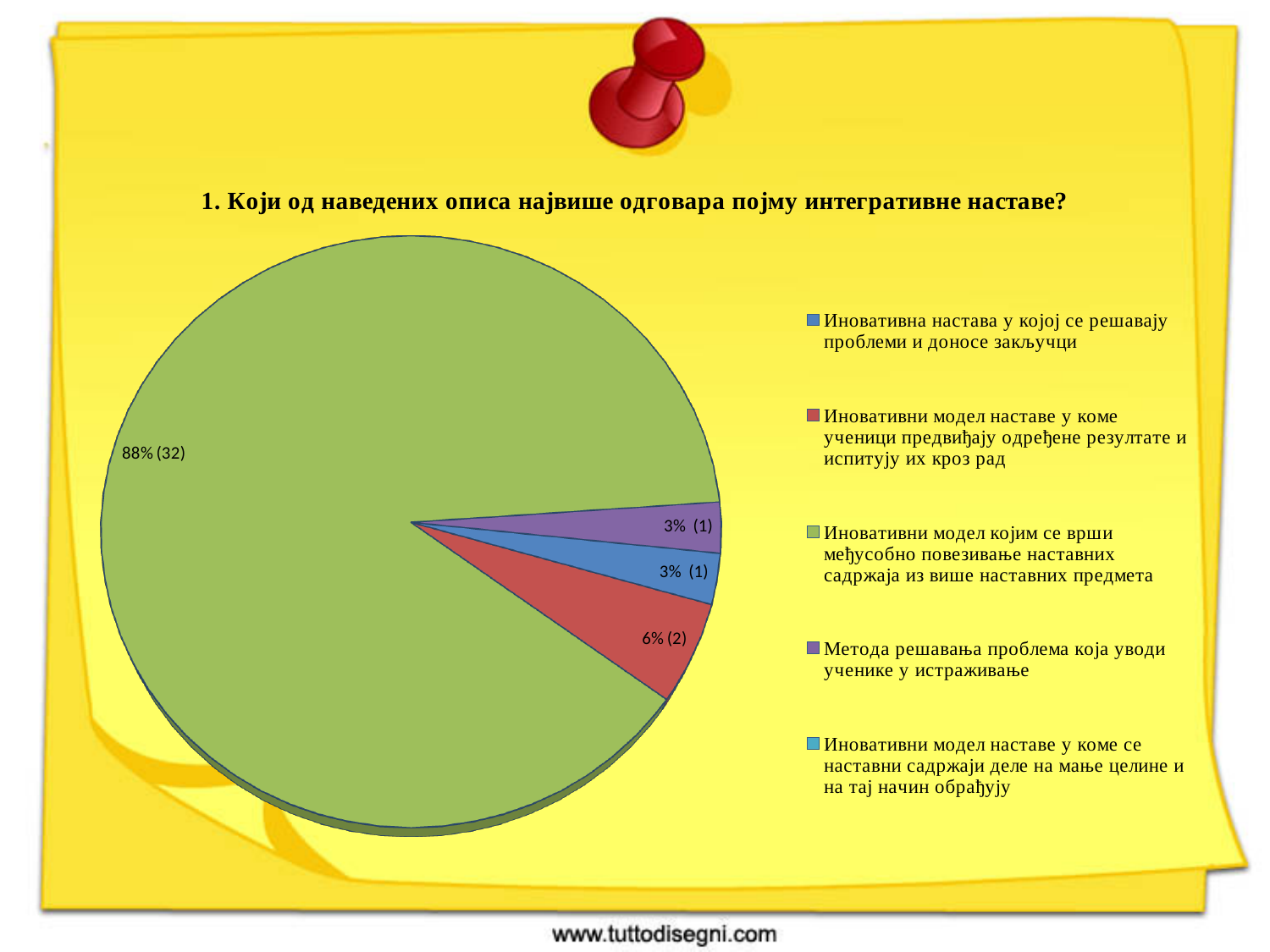
Which slice is larger, the red one (6%) or the blue one (3%)? The red one Is the share of the green slice greater or less than 50%? greater What kind of chart is shown on the slide? Pie chart What is the title of the chart? 1. Који од наведених описа највише одговара појму интегративне наставе? How many more respondents chose the green category (32) than the red category (2)? 30 What is the data label shown on the green slice (Иновативни модел којим се врши међусобно повезивање наставних садржаја из више наставних предмета)? 88% (32) What percentage share does the purple slice (Метода решавања проблема која уводи ученике у истраживање) have? 3% Which legend category has the largest slice of the pie? Иновативни модел којим се врши међусобно повезивање наставних садржаја из више наставних предмета How many respondents are shown in parentheses for the blue slice (Иновативна настава у којој се решавају проблеми и доносе закључци)? 1 How many entries does the legend of the pie chart list? 5 What is the data label shown on the red slice (Иновативни модел наставе у коме ученици предвиђају одређене резултате и испитују их кроз рад)? 6% (2) How many slices with data labels are visible in the pie chart? 4